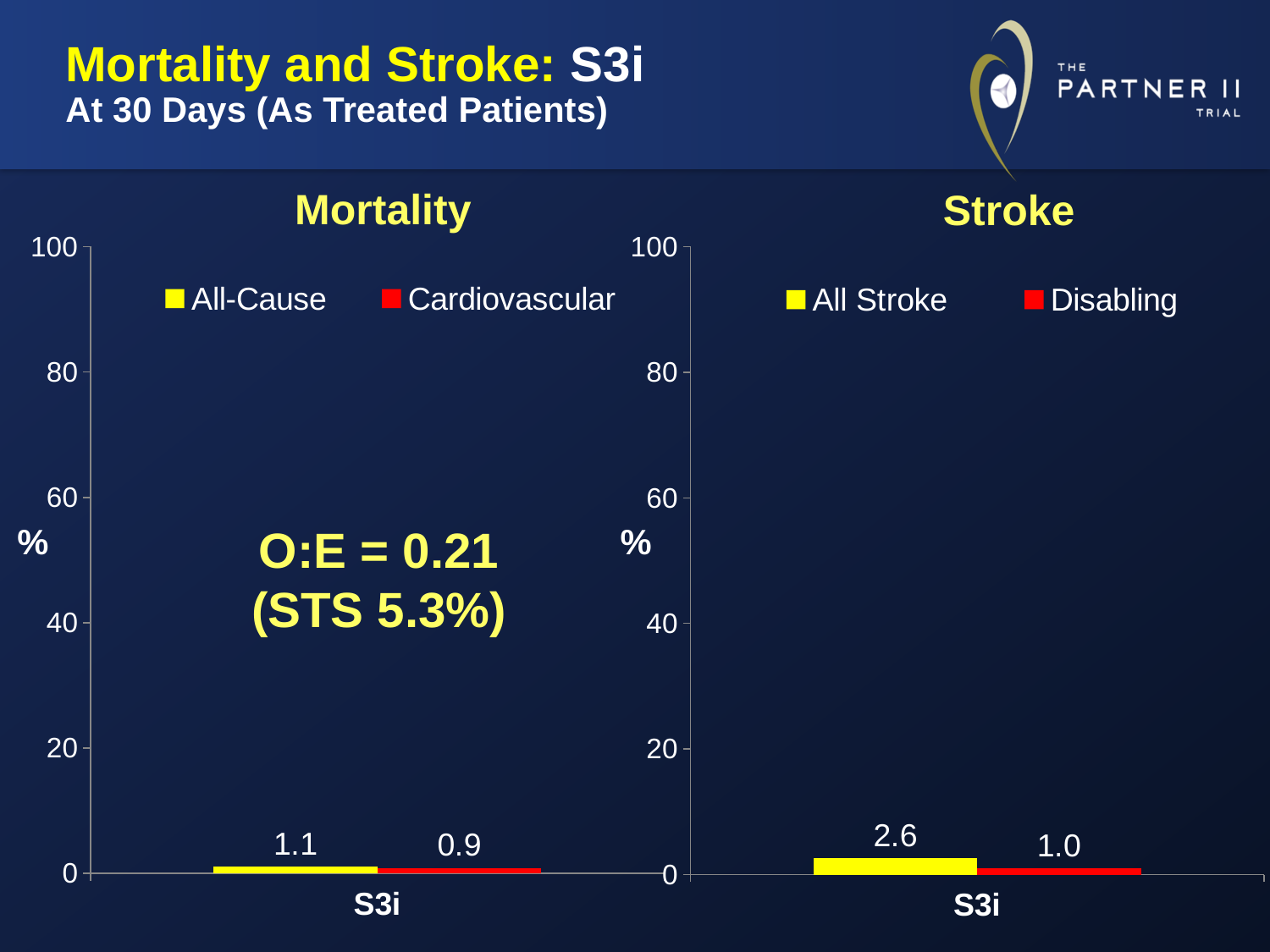
What is the category label on the x axis of the Stroke chart? S3i How many series does the legend of the Stroke chart list? 2 In the Mortality chart, what is the difference between the All-Cause and Cardiovascular values? 0.2 In the Stroke chart, what is the value for All Stroke? 2.6 In the Mortality chart, is the value for All-Cause greater or less than 20? less In the Mortality chart, what is the value for All-Cause? 1.1 In the Stroke chart, which series has the higher value, All Stroke or Disabling? All Stroke In the Stroke chart, what is the difference between the All Stroke and Disabling values? 1.6 In the Mortality chart, what is the value for Cardiovascular? 0.9 In the Stroke chart, what is the value for Disabling? 1.0 What kind of chart is the Mortality chart? bar chart In the Mortality chart, what colour is the Cardiovascular bar? red